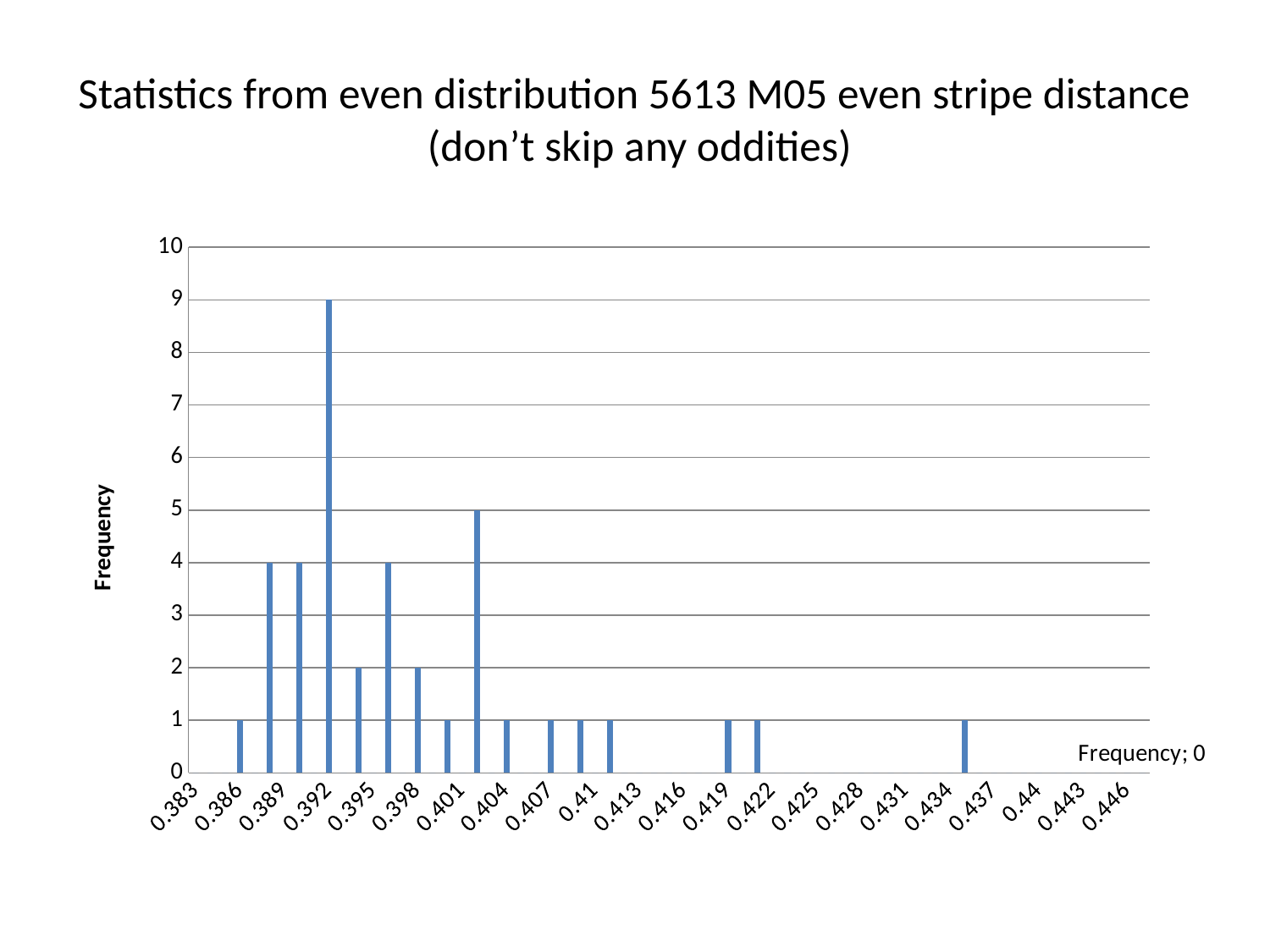
What kind of chart is shown on the slide? bar chart How many bars are plotted in the chart? 16 What is the label on the vertical axis? Frequency How many bars have a frequency of exactly 1? 9 Is the tallest bar's frequency greater or less than 8? greater What is the first (leftmost) label on the horizontal axis? 0.383 What is the difference between the tallest bar's frequency and the second-tallest bar's frequency? 4 What is the last (rightmost) label on the horizontal axis? 0.446 What is the highest tick value shown on the vertical axis? 10 What is the second-highest frequency value reached by a bar in the chart? 5 What is the highest frequency value reached by any bar in the chart? 9 How many bars reach a frequency of exactly 4? 3